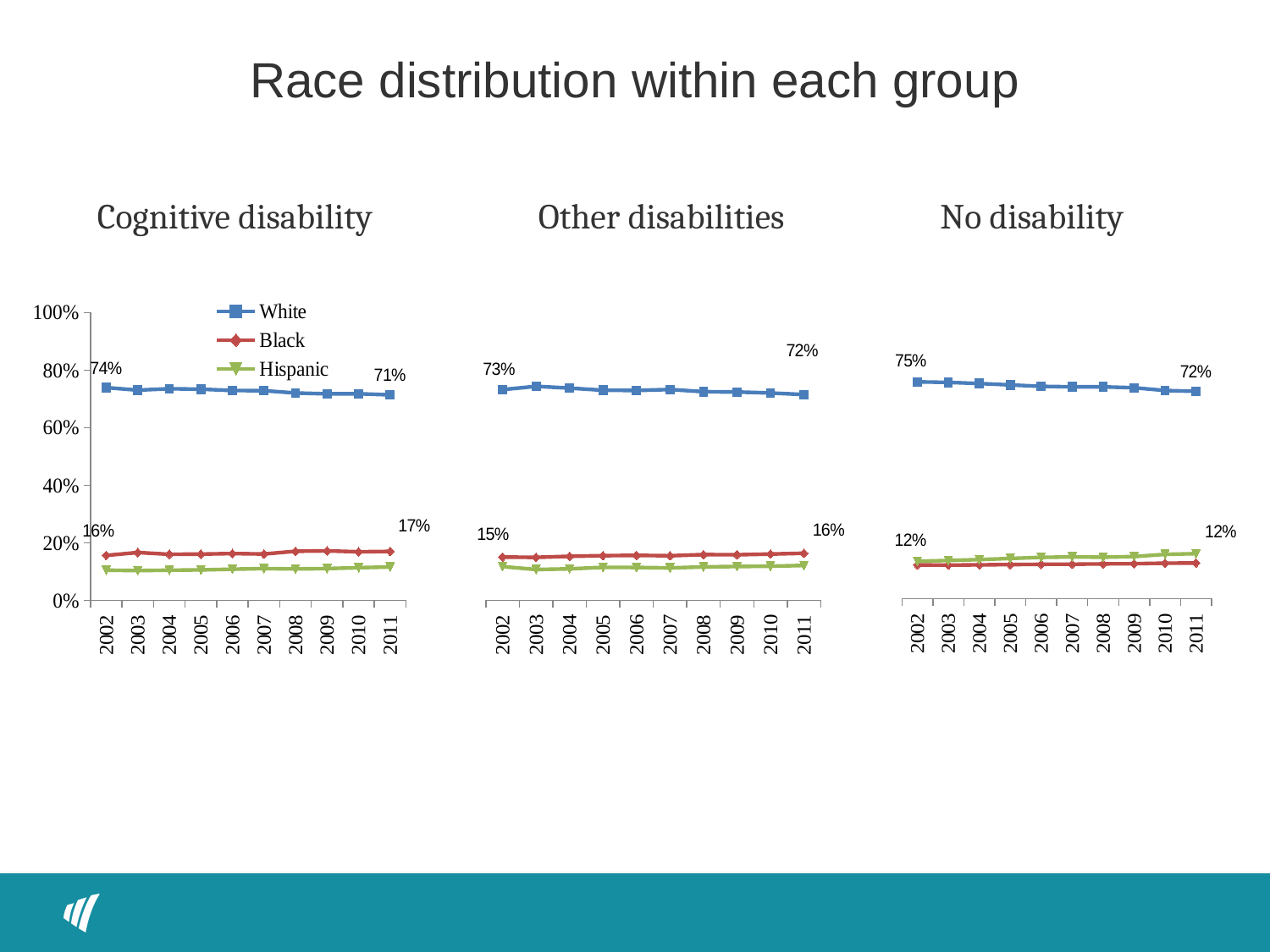
In the Cognitive disability chart, is the value for Hispanic in 2002 greater or less than 20%? less What kind of chart is the Other disabilities chart? Line chart Which chart shows a higher White share in 2002, Cognitive disability or No disability? No disability How many series does the legend on the Cognitive disability chart list? 3 In the Other disabilities chart, what is the value for White in 2002? 73% How many years are shown on the x axis of the No disability chart? 10 In the No disability chart, what is the value for White in 2002? 75% In the Cognitive disability chart, what is the value for White in 2011? 71% In the Cognitive disability chart, what is the value for Black in 2011? 17% In the Cognitive disability chart, by how many percentage points did the White share change from 2002 to 2011? 3 percentage points In the Other disabilities chart, what is the value for Black in 2011? 16% In the Cognitive disability chart, what is the value for White in 2002? 74%